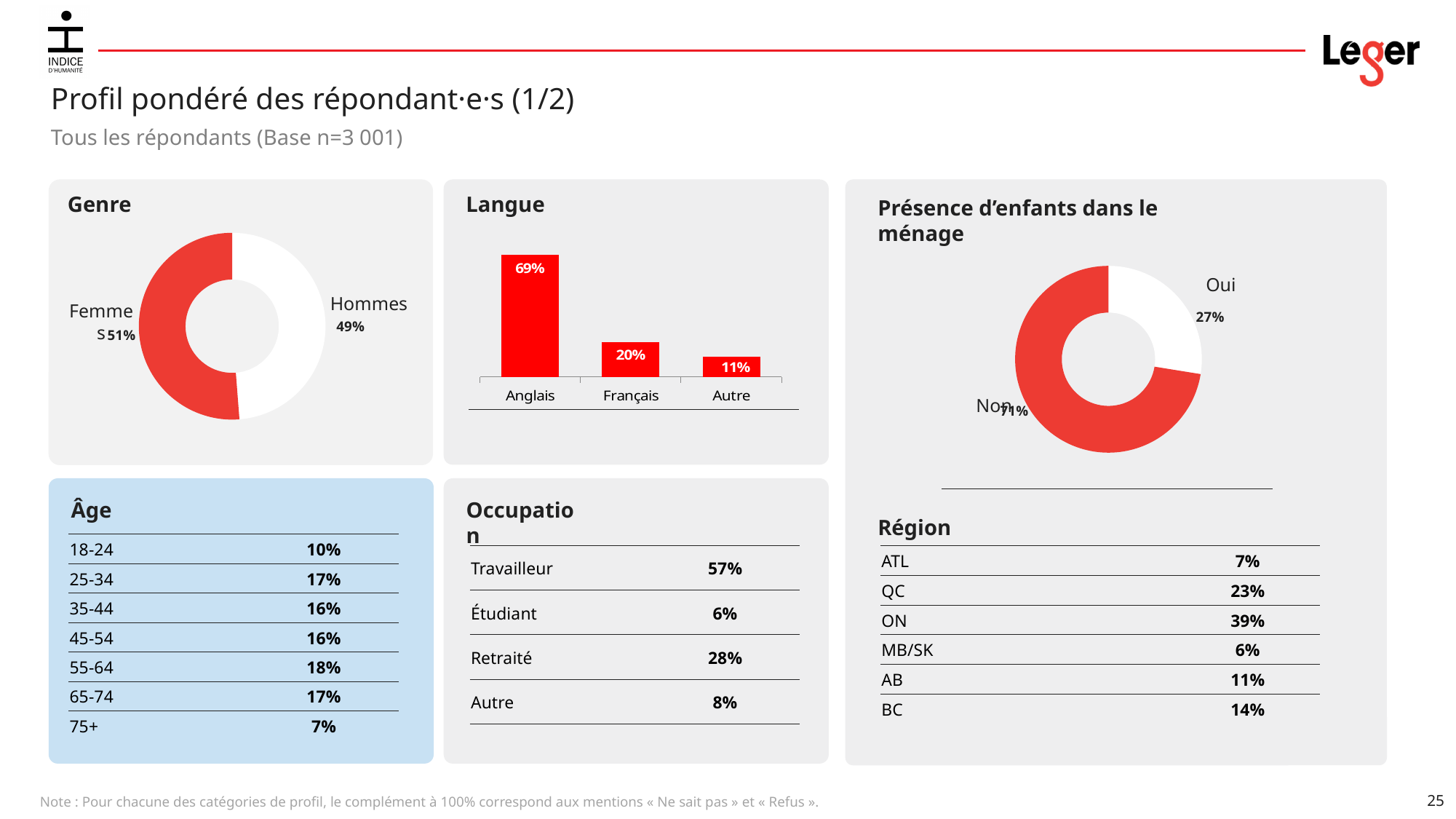
In the Langue chart, what is the value for Anglais? 69% In the Langue chart, which category has the lowest value? Autre In the Langue chart, which category has the highest value? Anglais In the Genre chart, what is the value for Hommes? 49% In the Langue chart, how many categories are shown? 3 What kind of chart is the Langue chart? Bar chart In the Langue chart, what is the value for Français? 20% In the Présence d'enfants dans le ménage chart, which is larger, Oui or Non? Non What kind of chart is the Présence d'enfants dans le ménage chart? Donut chart In the Présence d'enfants dans le ménage chart, what is the value for Oui? 27% In the Genre chart, what is the share for Femme? 51% In the Langue chart, what is the difference between the values for Anglais and Français? 49%